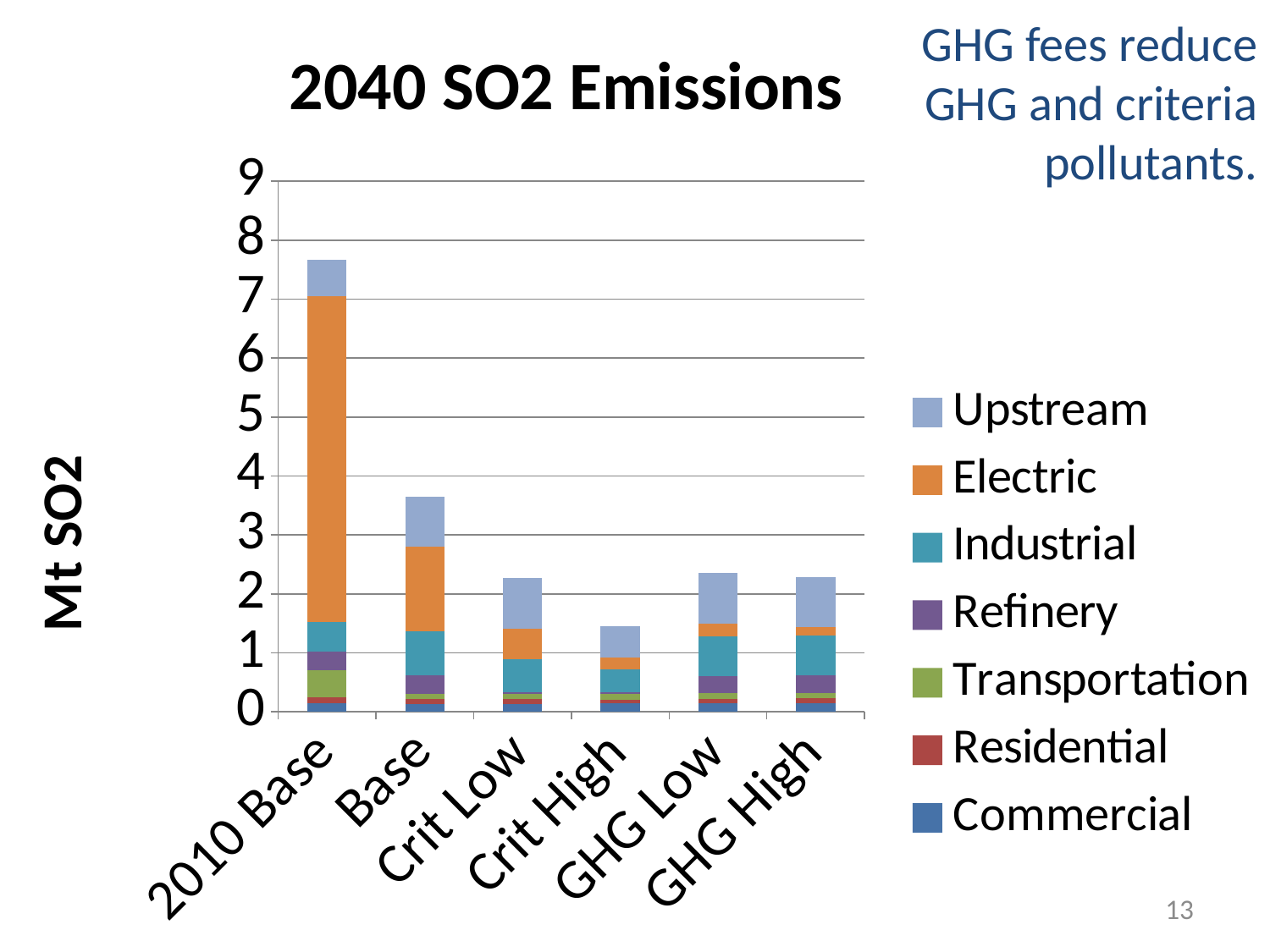
Which category has the lowest total SO2 emissions? Crit High How many categories are shown on the x axis of the chart? 6 What is the label on the vertical axis of the chart? Mt SO2 Is the total value for Base greater or less than 4? less Which has the larger total SO2 emissions, Base or Crit High? Base Is the total value for GHG Low greater or less than 2? greater Is the total value for Crit High greater or less than 2? less What kind of chart is shown on the slide? Stacked bar chart What is the title of the chart? 2040 SO2 Emissions Which category has the highest total SO2 emissions? 2010 Base How many series does the legend list? 7